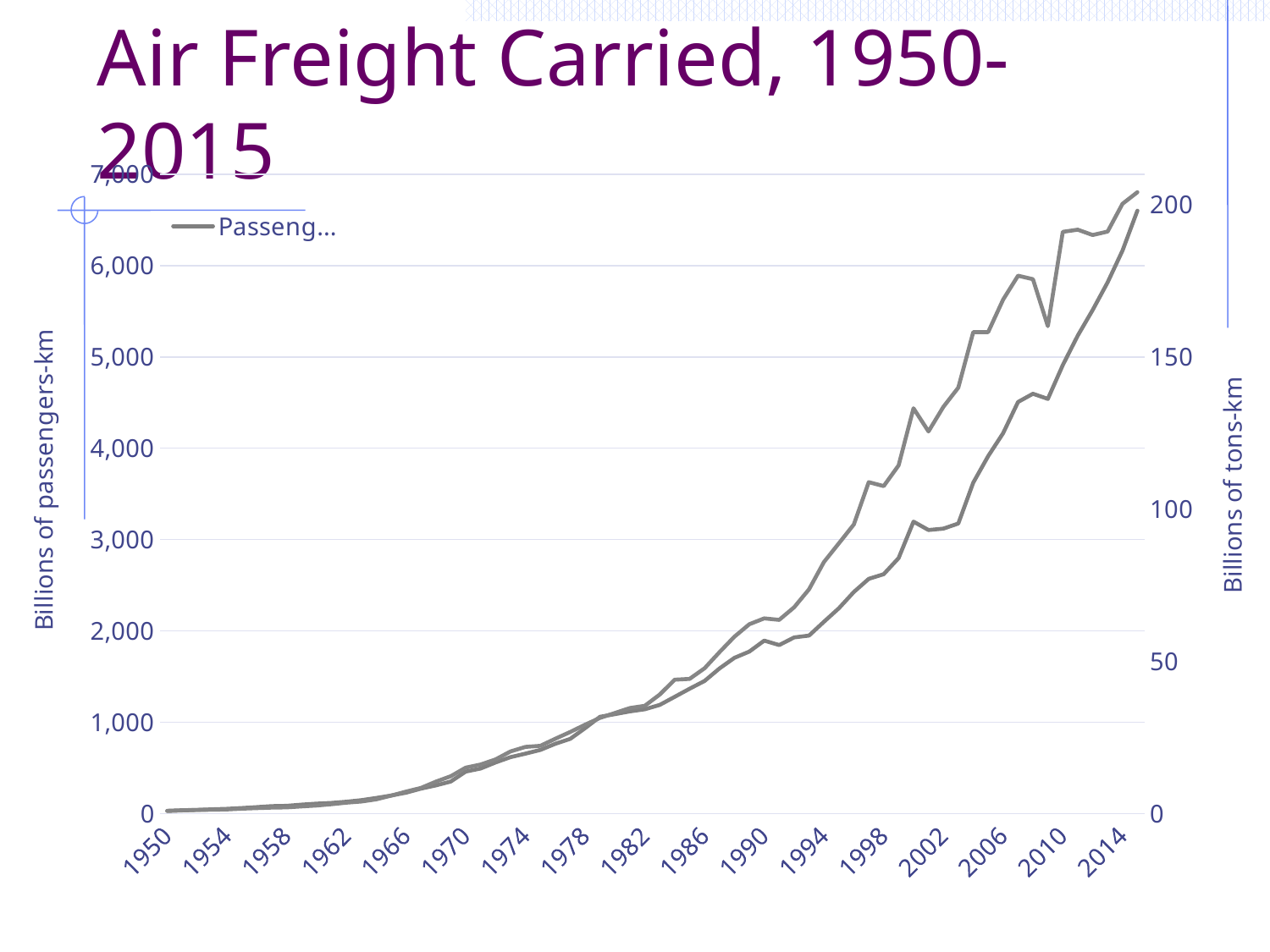
What is the highest tick value shown on the right vertical axis? 200 What kind of chart is shown on the slide? line chart What is the title of the left vertical axis? Billions of passengers-km What is the first year labelled on the x axis? 1950 How many year labels are shown on the x axis? 17 What is the highest tick value shown on the left vertical axis? 7,000 How many lines are plotted on the chart? 2 What is the last year labelled on the x axis? 2014 What is the title of the chart? Air Freight Carried, 1950-2015 Do the plotted values generally rise or fall from 1950 to 2014? rise